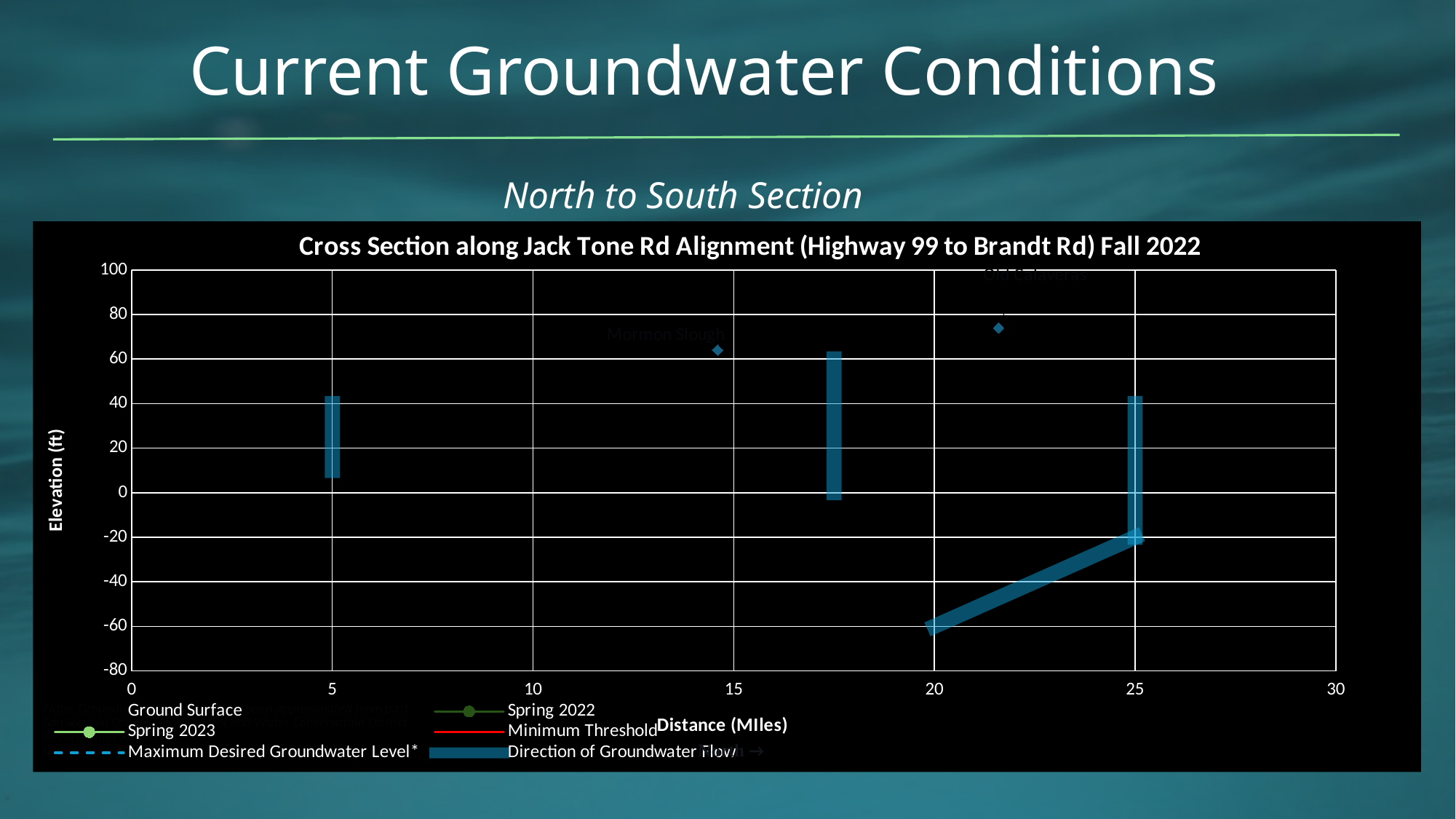
How many entries does the chart's legend list? 6 Is the elevation of the data point plotted near 15 miles greater or less than 40? greater What is the label of the vertical axis of the chart? Elevation (ft) What is the title of the chart? Cross Section along Jack Tone Rd Alignment (Highway 99 to Brandt Rd) Fall 2022 What kind of chart is shown on the slide? line chart Is the elevation of the data point plotted near 21.5 miles greater or less than 60? greater Is the elevation of the data point plotted at 20 miles greater or less than -40? less